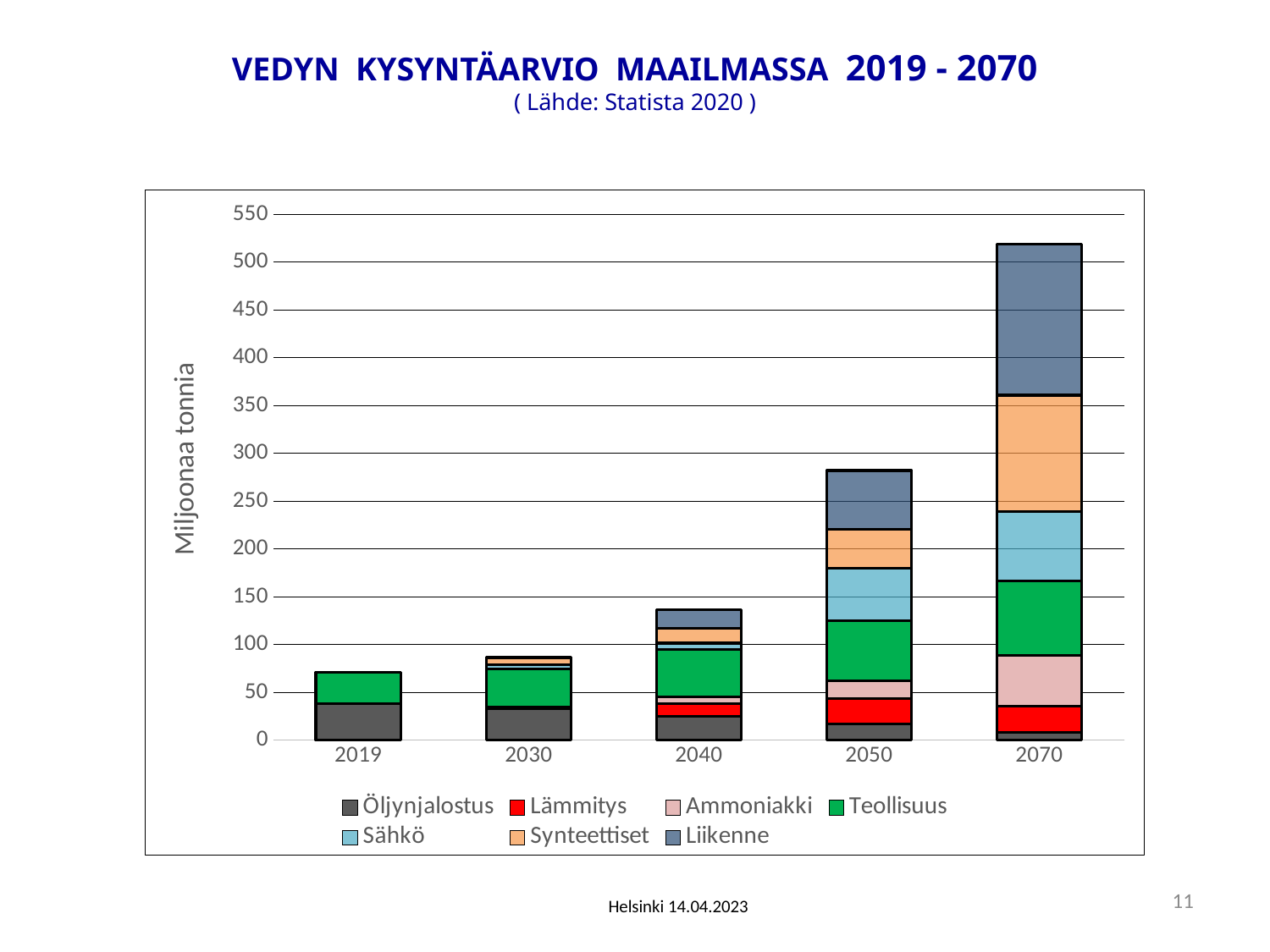
Which year has the highest total stacked bar? 2070 How many series does the chart's legend list? 7 How many years (categories) are shown on the x axis of the chart? 5 Is the total value for 2050 greater or less than 250? greater What kind of chart is shown on the slide? stacked bar chart Which year has the lowest total stacked bar? 2019 Which year has a larger total bar, 2040 or 2050? 2050 Do the total bar heights rise or fall from 2019 to 2070? rise What is the label of the vertical axis of the chart? Miljoonaa tonnia Is the total value for 2040 greater or less than 150? less Is the total value for 2030 greater or less than 100? less